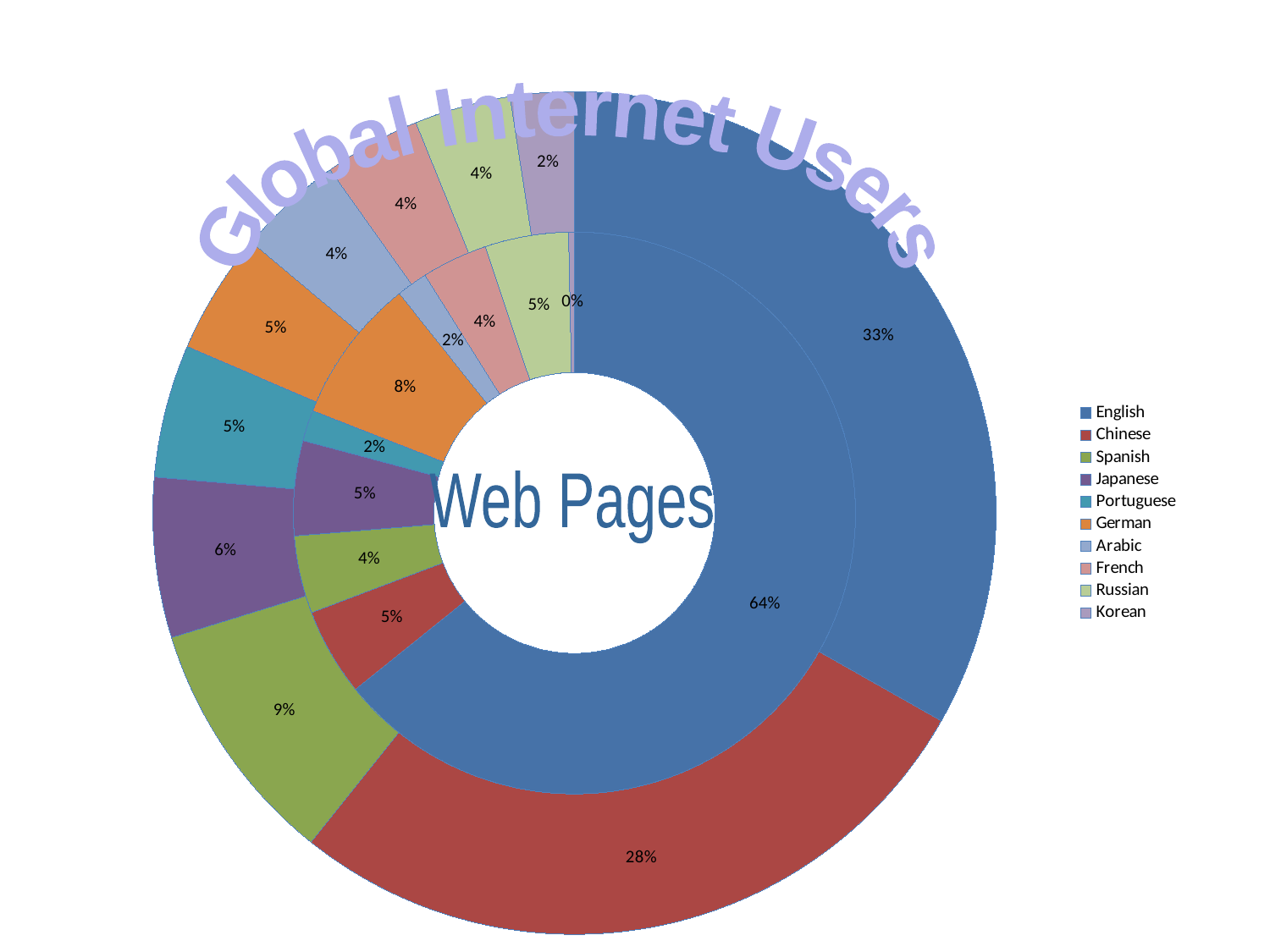
How many languages does the legend list? 10 Which language has the largest share of Web Pages (inner ring)? English What share of Global Internet Users (outer ring) is Spanish? 9% What share of Global Internet Users (outer ring) is Chinese? 28% Which language has the smallest share of Global Internet Users (outer ring)? Korean What share of Global Internet Users (outer ring) is English? 33% Which is larger: the Chinese share of Global Internet Users (outer ring) or the Chinese share of Web Pages (inner ring)? Global Internet Users What is the difference between the English share of Web Pages (64%) and the English share of Global Internet Users (33%)? 31% What share of Web Pages (inner ring) is German? 8% What share of Web Pages (inner ring) is English? 64% Which language has the smallest share of Web Pages (inner ring)? Korean What kind of chart is shown on the slide? Doughnut chart